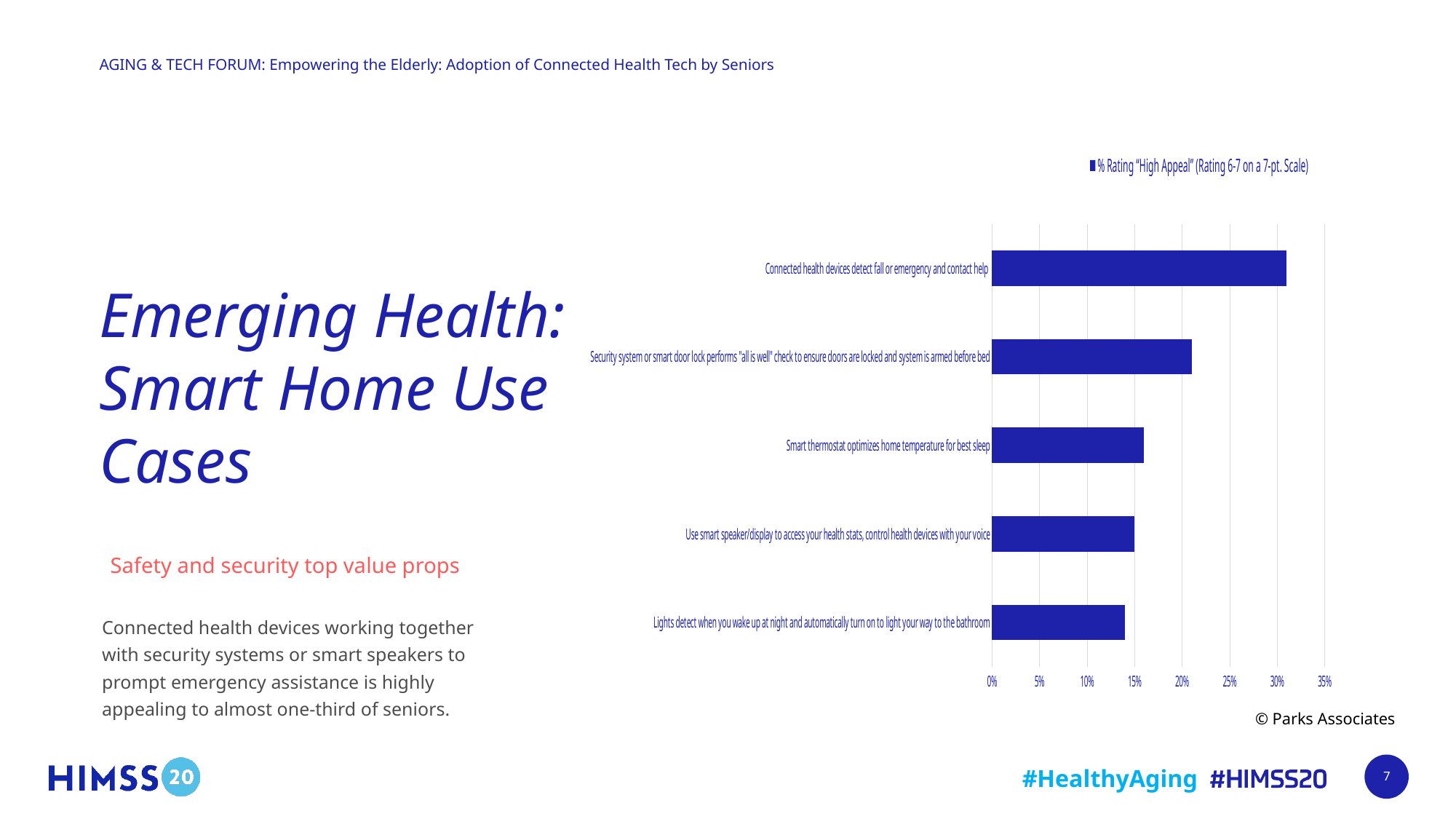
Which has a higher % rating "High Appeal": "Connected health devices detect fall or emergency and contact help" or "Security system or smart door lock performs 'all is well' check"? Connected health devices detect fall or emergency and contact help What is the series name shown in the chart legend? % Rating "High Appeal" (Rating 6-7 on a 7-pt. Scale) Is the value for "Smart thermostat optimizes home temperature for best sleep" greater or less than 20%? less Which use case has the highest % rating "High Appeal"? Connected health devices detect fall or emergency and contact help Is the value for "Lights detect when you wake up at night and automatically turn on to light your way to the bathroom" greater or less than 10%? greater Is the value for "Connected health devices detect fall or emergency and contact help" greater or less than 25%? greater How many use cases (categories) are plotted in the chart? 5 Which has a higher % rating "High Appeal": "Security system or smart door lock performs 'all is well' check" or "Smart thermostat optimizes home temperature for best sleep"? Security system or smart door lock performs "all is well" check Do the bar values increase or decrease going from the top category to the bottom category? decrease What kind of chart is shown on the slide? bar chart How many series does the chart legend list? 1